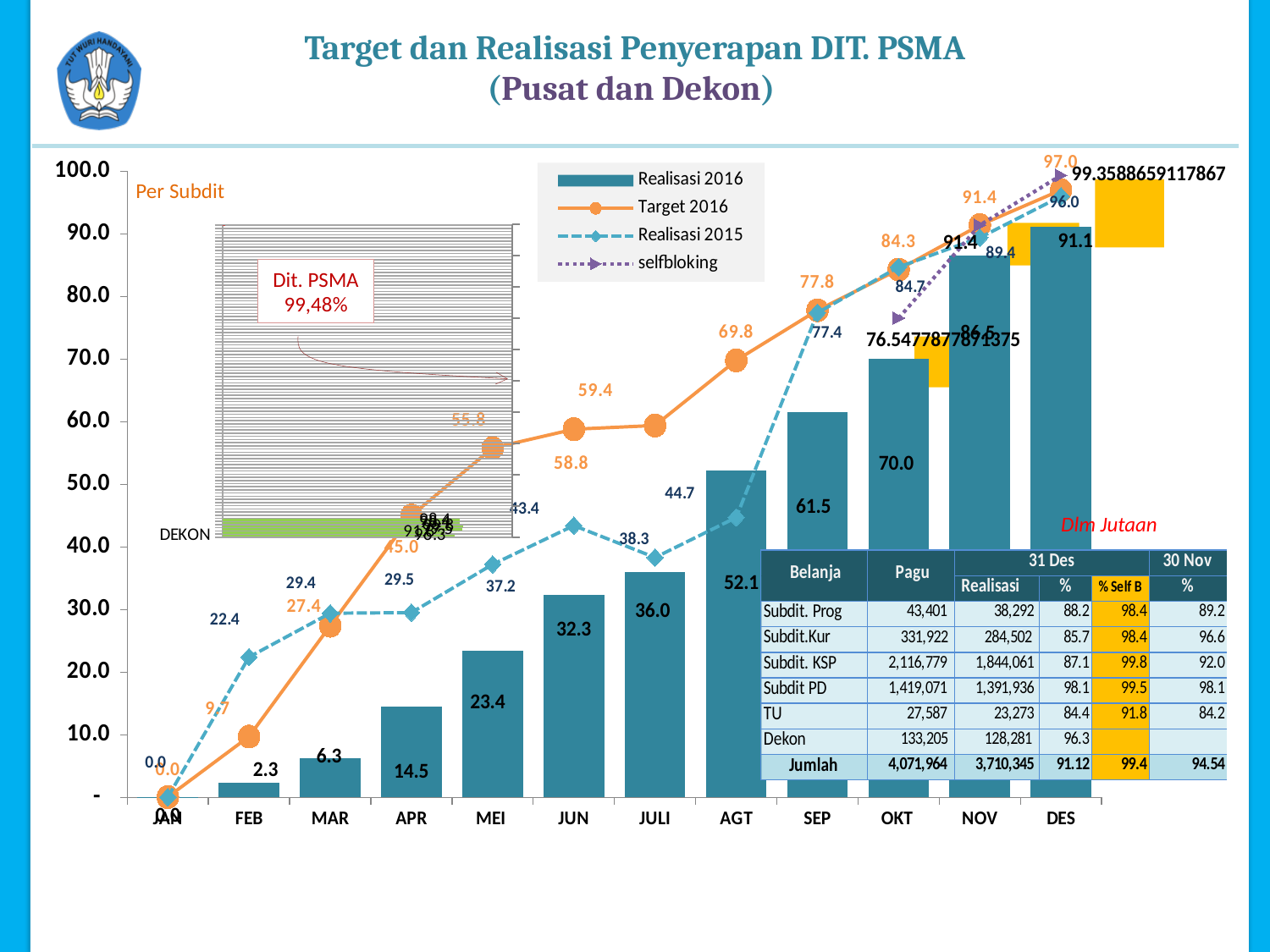
Is the Realisasi 2016 value for OKT greater or less than 60.0? greater Which month has the highest Realisasi 2016 bar? DES What is the Realisasi 2015 value for FEB? 22.4 What is the difference between the Target 2016 value (97.0) and the Realisasi 2016 value (91.1) for DES? 5.9 What is the Target 2016 value for AGT? 69.8 How many months are shown on the x axis? 12 What is the Realisasi 2016 value for DES? 91.1 Which is larger for JULI: the Target 2016 value or the Realisasi 2016 value? Target 2016 Do the Realisasi 2016 bars rise or fall from JAN to DES? rise What is the Realisasi 2016 value for SEP? 61.5 How many series does the legend list? 4 Which month has the lowest Realisasi 2016 bar? JAN